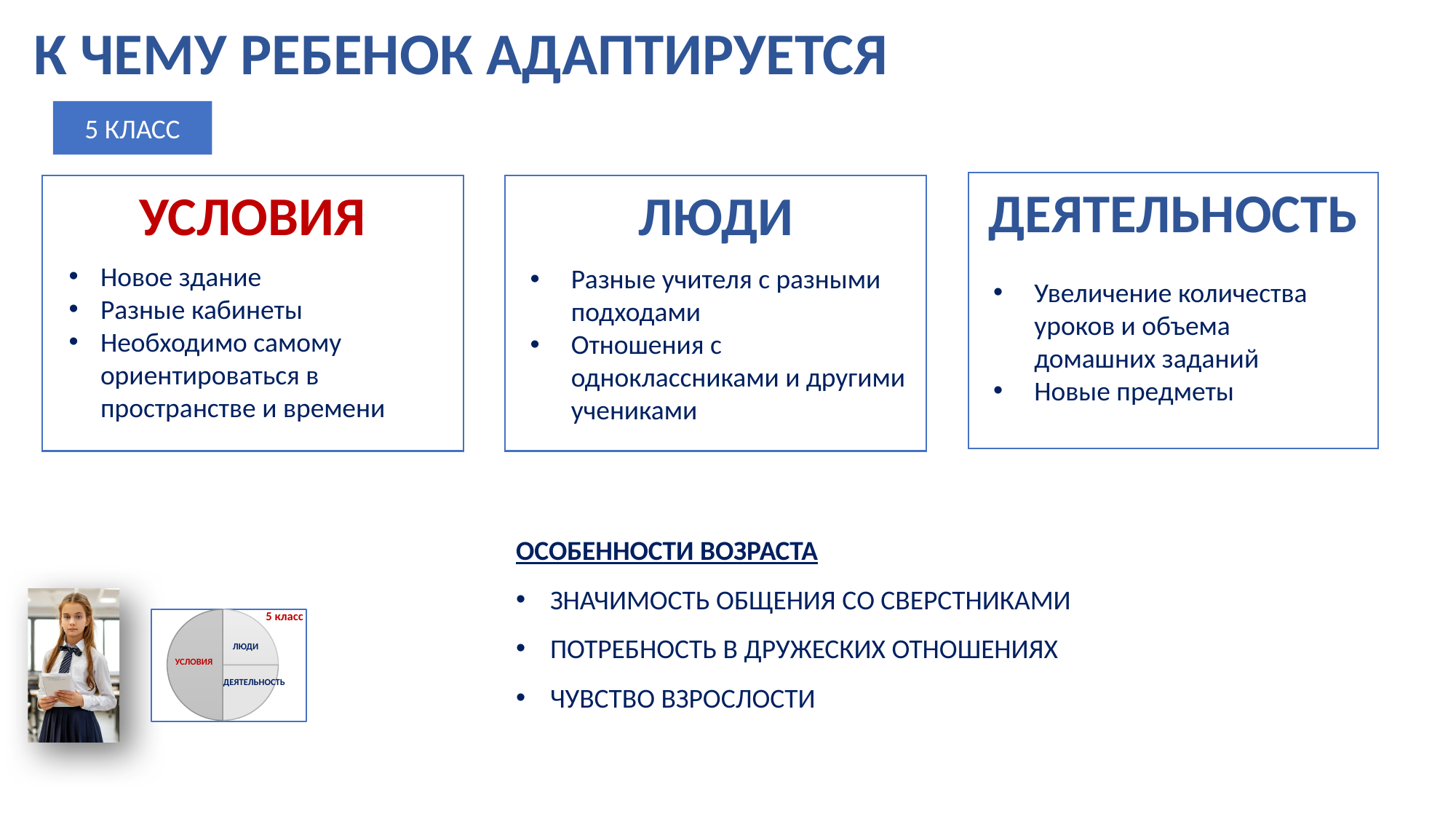
In the pie chart, which slice is larger: УСЛОВИЯ or ЛЮДИ? УСЛОВИЯ Which slice of the pie chart is the largest? УСЛОВИЯ What kind of chart is shown at the bottom left of the slide? pie chart In the pie chart, which slice is larger: ДЕЯТЕЛЬНОСТЬ or УСЛОВИЯ? УСЛОВИЯ What is the title shown in the corner of the pie chart? 5 класс Which slice label in the pie chart is written in red? УСЛОВИЯ How many slices does the pie chart have? 3